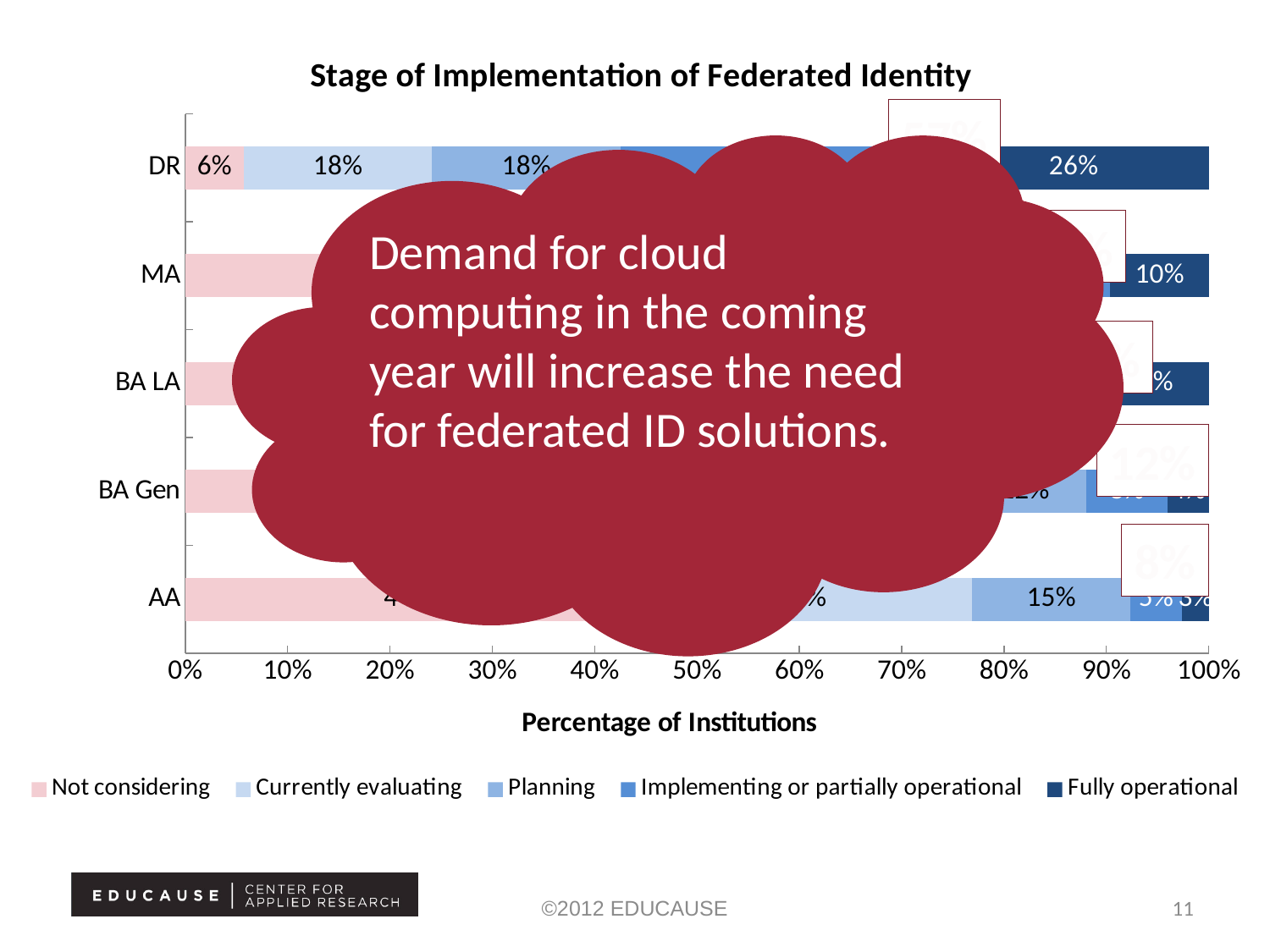
What is the difference between the 'Fully operational' values for DR and MA? 16% Which is larger, the 'Fully operational' value for DR or for MA? DR What is the 'Currently evaluating' value for DR? 18% How many institution categories are shown on the vertical axis? 5 What type of chart is shown on the slide? stacked bar chart What is the 'Not considering' value for DR? 6% What is the title of the chart? Stage of Implementation of Federated Identity What is the label of the horizontal axis? Percentage of Institutions What is the 'Fully operational' value for DR? 26% How many series does the legend list? 5 What is the 'Fully operational' value for MA? 10% What is the 'Planning' value for AA? 15%